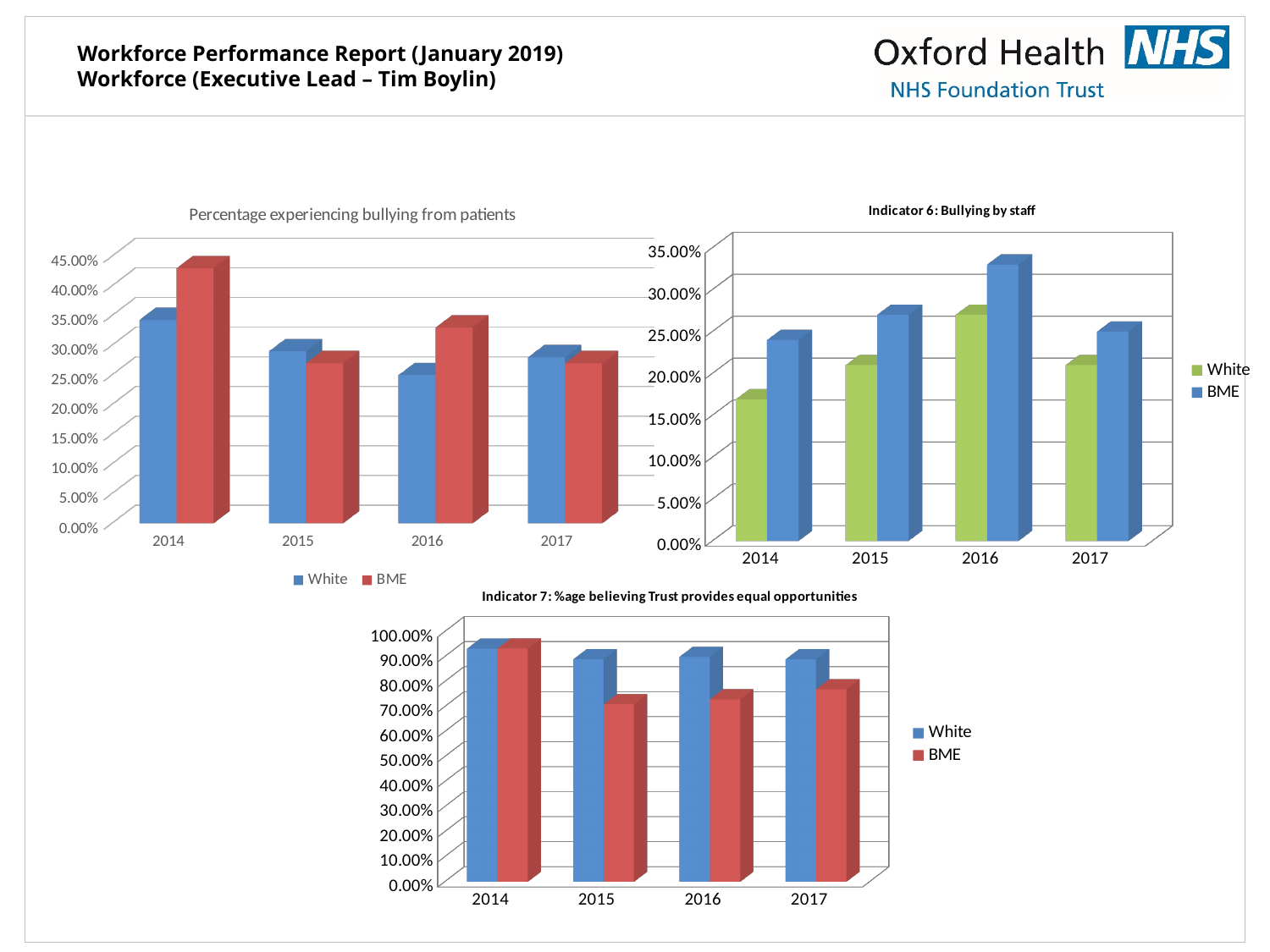
In the chart titled 'Indicator 6: Bullying by staff', is the White value for 2014 greater or less than 20.00%? less In the chart titled 'Percentage experiencing bullying from patients', is the White value for 2016 greater or less than 30.00%? less In the chart titled 'Indicator 6: Bullying by staff', which year has the highest value for BME? 2016 In the chart titled 'Indicator 6: Bullying by staff', do the White values rise or fall from 2014 to 2016? rise In the chart titled 'Percentage experiencing bullying from patients', is the BME value for 2014 greater or less than 40.00%? greater How many years are shown on the x axis of the chart titled 'Indicator 6: Bullying by staff'? 4 In the chart titled 'Indicator 6: Bullying by staff', which series has the larger value in 2016, White or BME? BME In the chart titled 'Indicator 7: %age believing Trust provides equal opportunities', which series has the larger value in 2017, White or BME? White How many series does the legend list in the chart titled 'Indicator 7: %age believing Trust provides equal opportunities'? 2 In the chart titled 'Percentage experiencing bullying from patients', which year has the highest value for BME? 2014